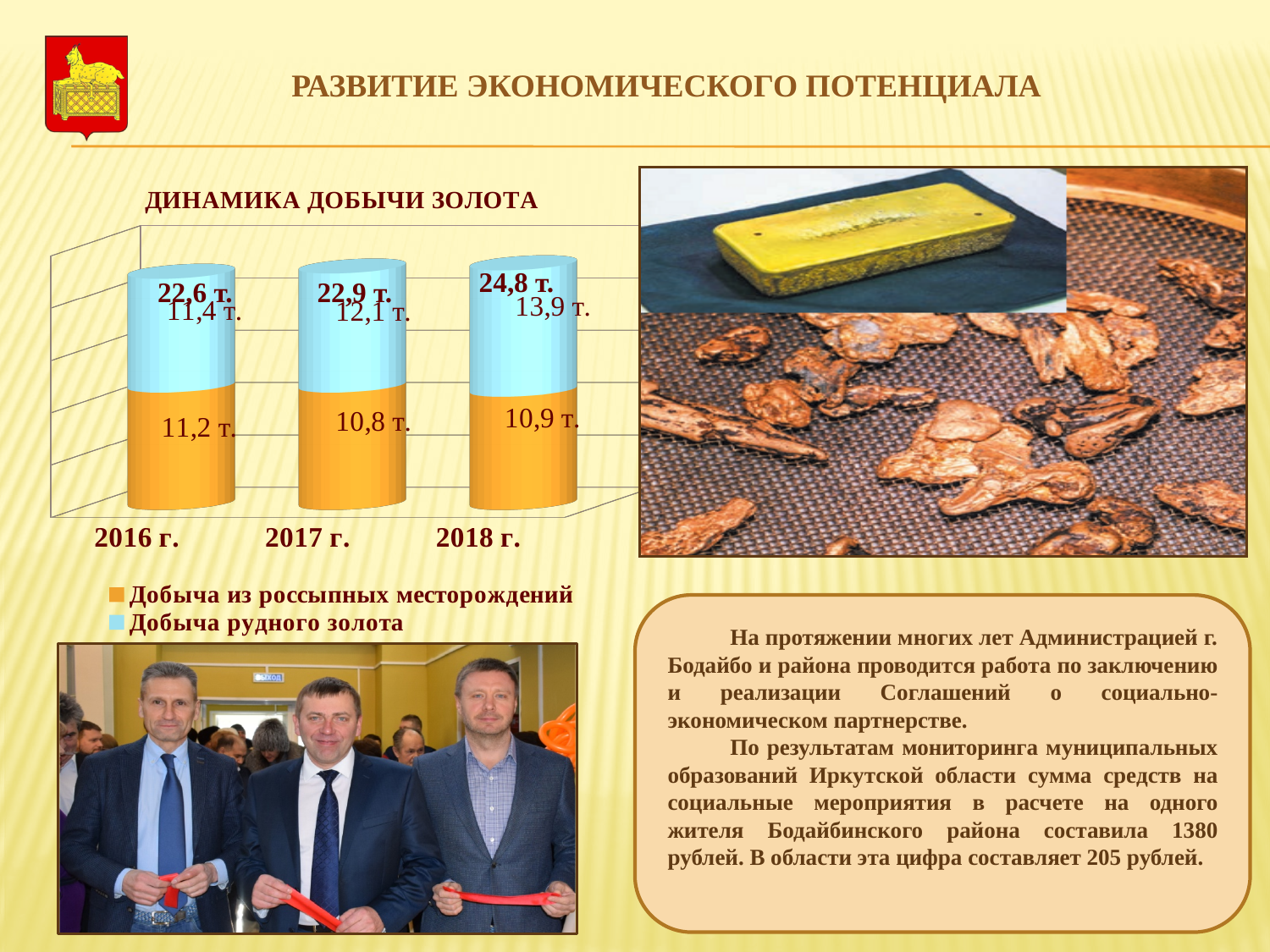
What type of chart is shown under the title «ДИНАМИКА ДОБЫЧИ ЗОЛОТА»? Stacked bar chart What is the value of «Добыча рудного золота» for 2018 г.? 13,9 т. What is the difference between «Добыча рудного золота» in 2018 г. and in 2016 г.? 2,5 т. Which year has the highest value of «Добыча рудного золота»? 2018 г. What is the value of «Добыча рудного золота» for 2017 г.? 12,1 т. How many series does the legend of the chart «ДИНАМИКА ДОБЫЧИ ЗОЛОТА» list? 2 What is the total gold production shown for 2018 г.? 24,8 т. What is the value of «Добыча из россыпных месторождений» for 2016 г.? 11,2 т. What is the total gold production shown for 2016 г.? 22,6 т. Which year has the lowest value of «Добыча из россыпных месторождений»? 2017 г. Does the total gold production rise or fall from 2016 г. to 2018 г.? Rises How many years (categories) are shown on the x axis of the chart «ДИНАМИКА ДОБЫЧИ ЗОЛОТА»? 3